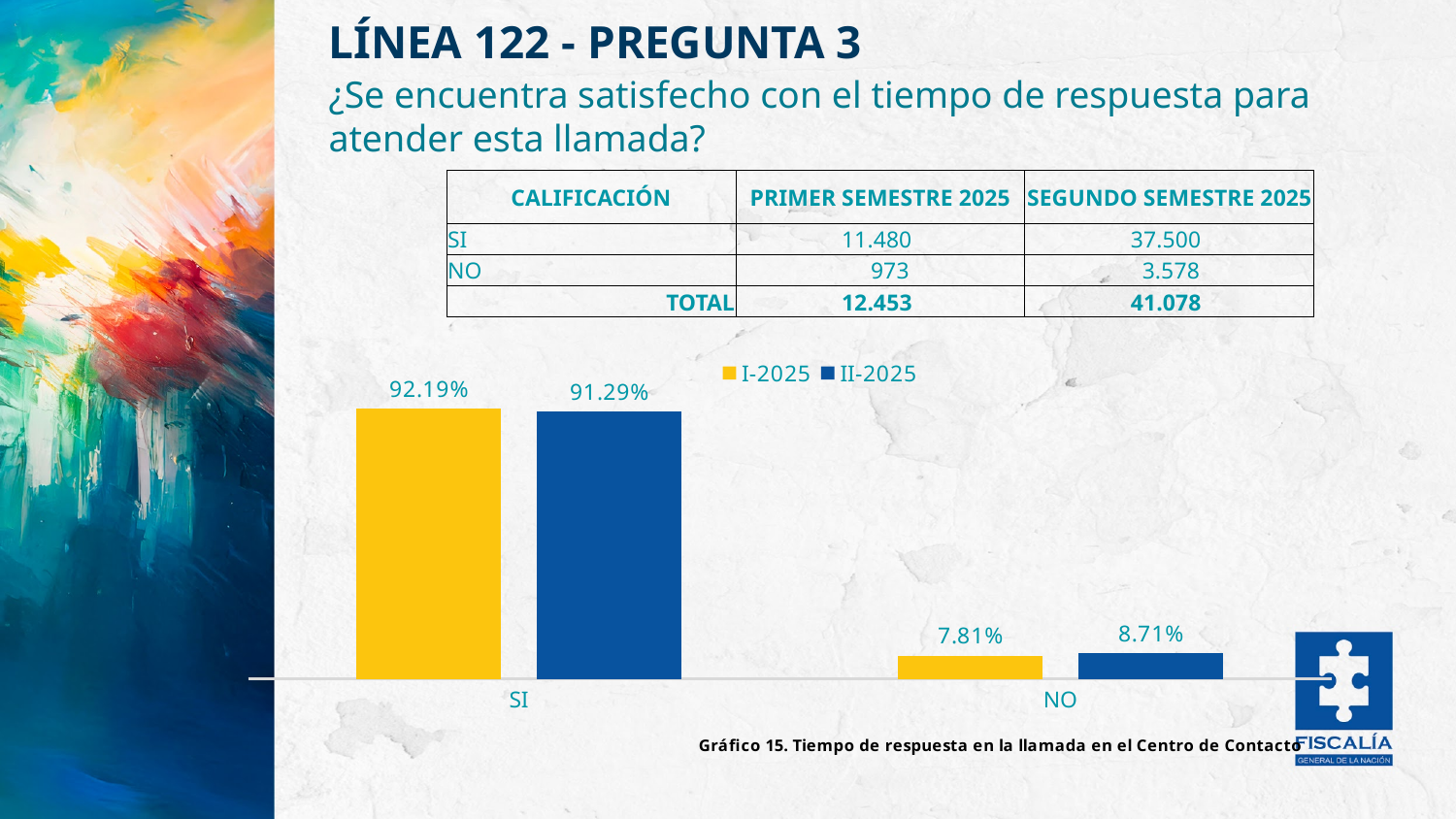
Which is larger for SI: the I-2025 value or the II-2025 value? I-2025 Which category has the lowest value in the II-2025 series? NO What kind of chart is shown on the slide? bar chart What is the value for SI in the II-2025 series? 91.29% What is the value for NO in the I-2025 series? 7.81% What is the difference between the I-2025 and II-2025 values for NO? 0.90% How many categories are shown on the x axis of the chart? 2 What is the value for SI in the I-2025 series? 92.19% What colour are the bars for the II-2025 series? blue What is the value for NO in the II-2025 series? 8.71% Which category has the highest value in the I-2025 series? SI How many series does the chart legend list? 2